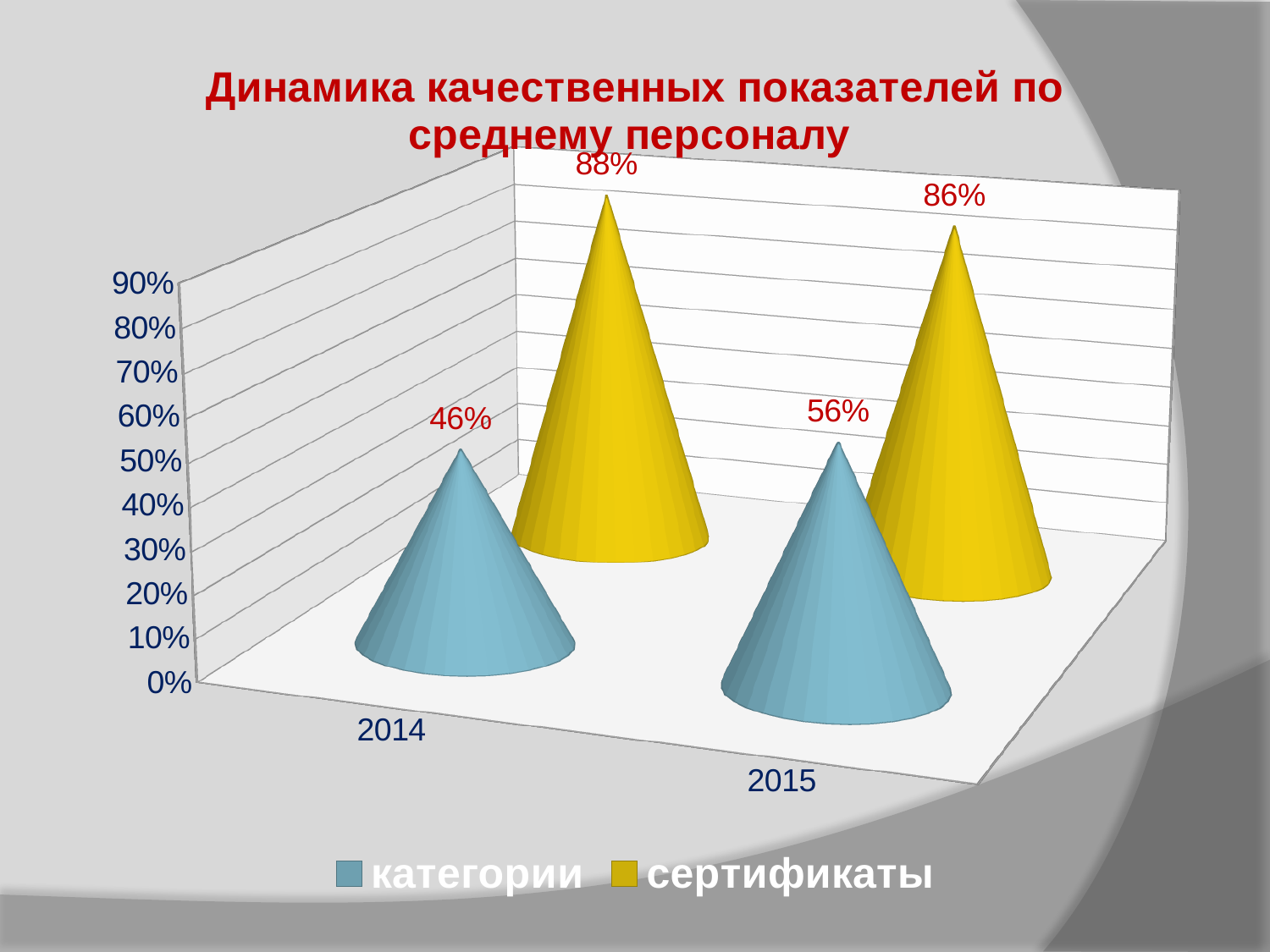
What is the value for категории in 2015? 56% What is the value for сертификаты in 2015? 86% What is the value for сертификаты in 2014? 88% How many series does the legend list? 2 How many years are shown on the x axis? 2 Which is larger in 2014: категории or сертификаты? сертификаты Does the value for категории rise or fall from 2014 to 2015? rise What is the difference between the категории values for 2015 and 2014? 10% Which year has the higher value for категории? 2015 Which year has the lower value for сертификаты? 2015 What is the value for категории in 2014? 46% What is the difference between the сертификаты values for 2014 and 2015? 2%